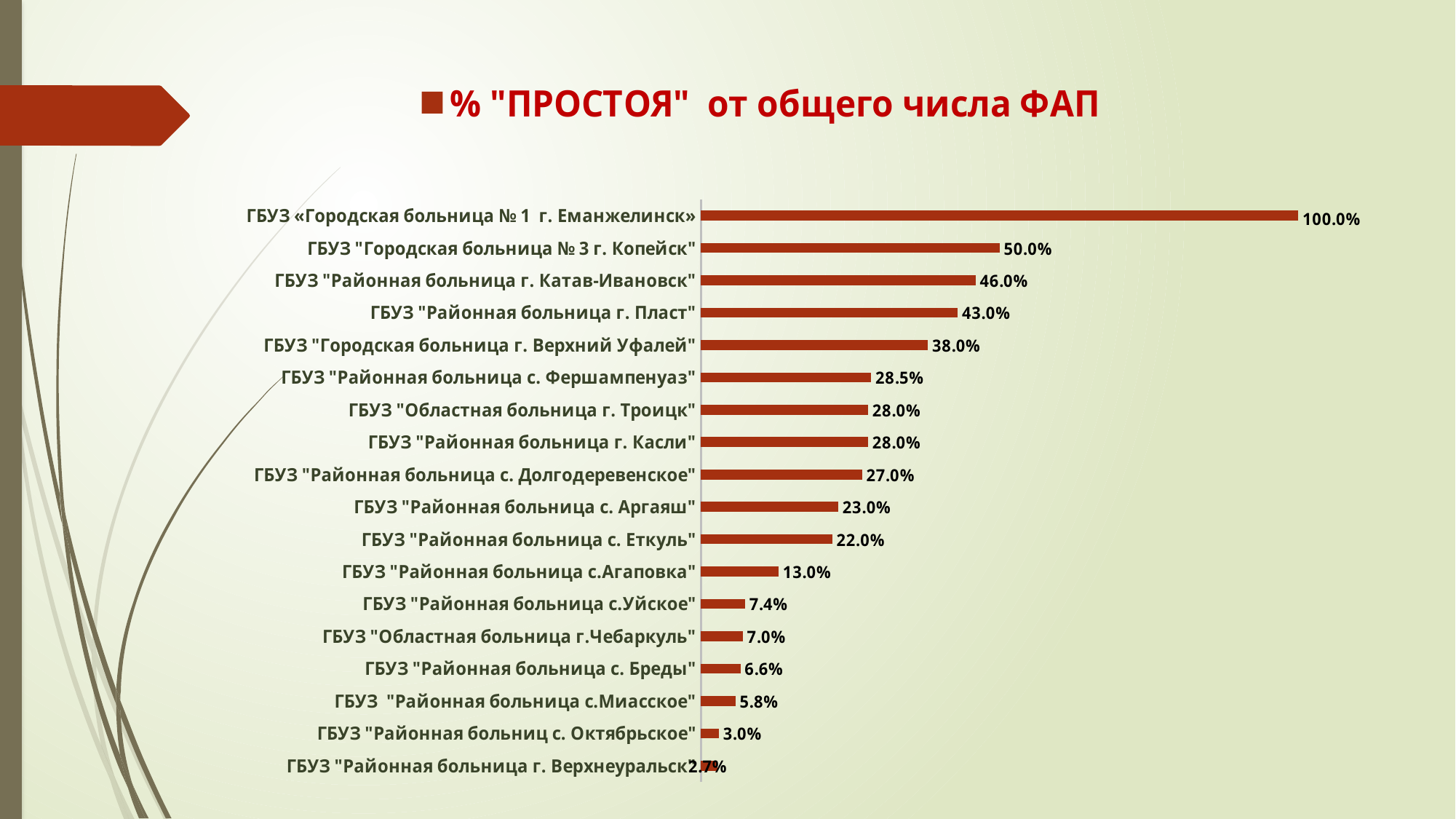
How many hospitals are shown in the chart? 18 Which hospital has the highest value? ГБУЗ «Городская больница № 1 г. Еманжелинск» What is the difference between the values for ГБУЗ "Районная больница г. Катав-Ивановск" and ГБУЗ "Районная больница г. Пласт"? 3.0% Which hospital has the lowest value? ГБУЗ "Районная больница г. Верхнеуральск" What type of chart is shown on the slide? bar chart What is the value for ГБУЗ "Городская больница № 3 г. Копейск"? 50.0% What is the value for ГБУЗ "Районная больница с.Уйское"? 7.4% What is the title of the chart? % "ПРОСТОЯ" от общего числа ФАП What is the value for ГБУЗ "Районная больница с. Фершампенуаз"? 28.5% Which has a larger value: ГБУЗ "Районная больница с. Еткуль" or ГБУЗ "Районная больница с.Агаповка"? ГБУЗ "Районная больница с. Еткуль" What is the value for ГБУЗ "Районная больниц с. Октябрьское"? 3.0% What is the difference between the values for ГБУЗ "Городская больница г. Верхний Уфалей" and ГБУЗ "Районная больница с. Аргаяш"? 15.0%